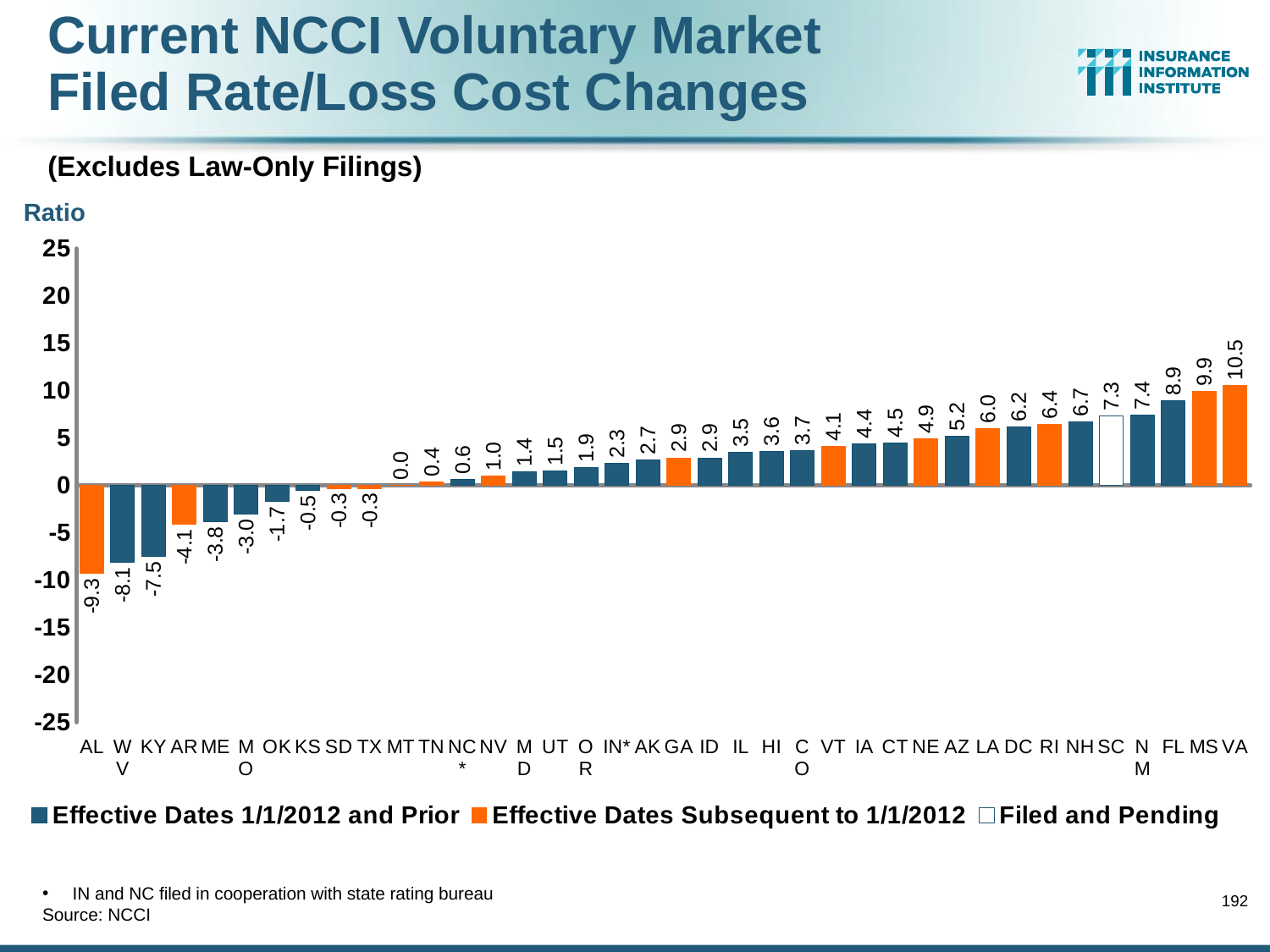
What is the difference between the values for VA and AL? 19.8 What is the value for AL? -9.3 What is the value for VA? 10.5 Is the value for VA greater or less than 10? greater Which is larger, the value for FL or the value for MS? MS What kind of chart is this? bar chart Which state has the lowest value? AL How many series does the legend list? 3 What is the value for MT? 0.0 How many states are shown on the x axis? 38 Which state has the highest value? VA Which state's bar is shown as Filed and Pending? SC